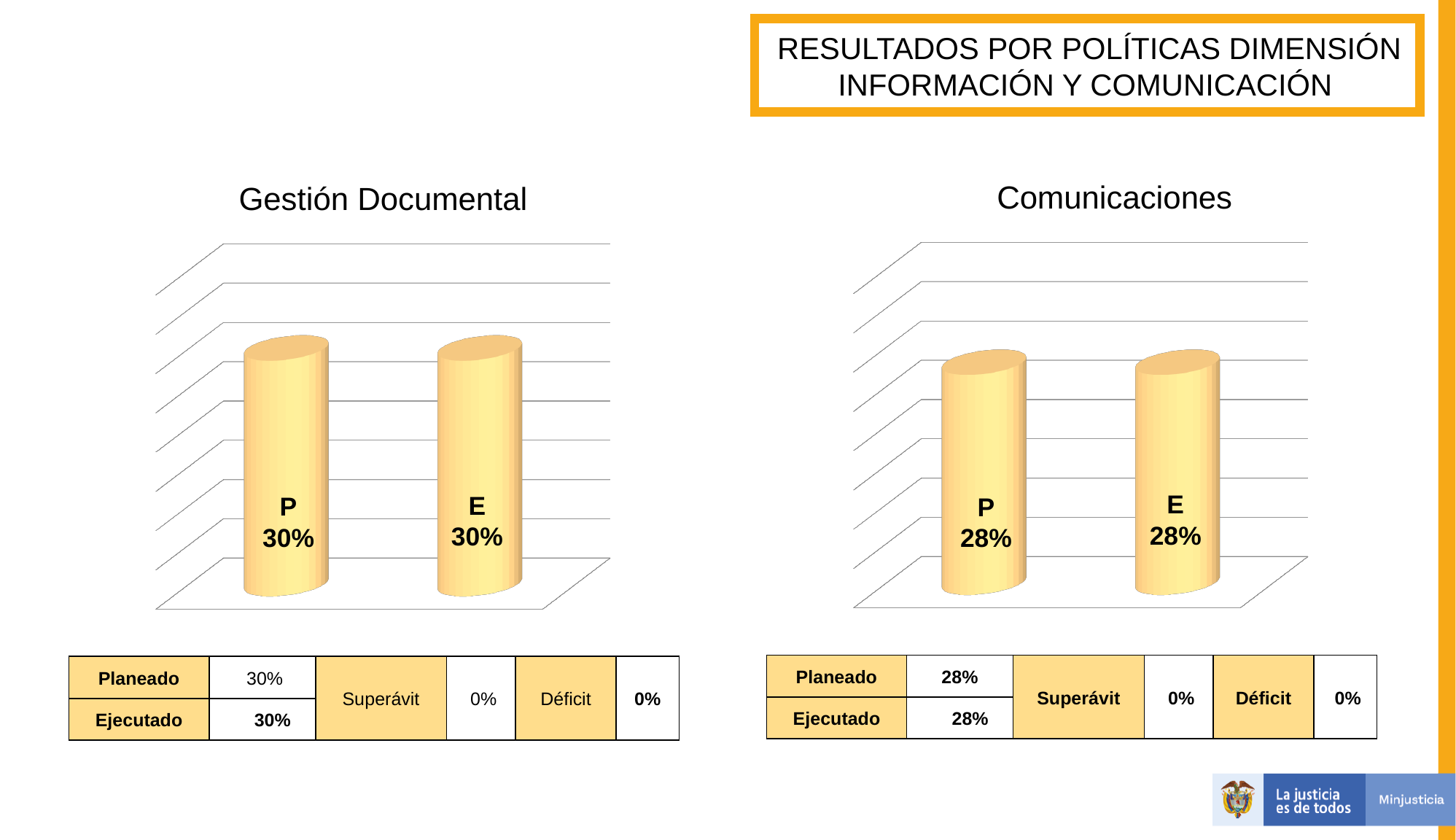
How many bars does the Comunicaciones chart show? 2 In the Gestión Documental chart, what is the difference between the P and E values? 0% In the Gestión Documental chart, what is the value for E? 30% In the Comunicaciones chart, what is the value for E? 28% What kind of chart is the Comunicaciones chart? Bar chart What kind of chart is the Gestión Documental chart? Bar chart What is the title of the chart on the left side of the slide? Gestión Documental In the Gestión Documental chart, what is the value for P? 30% What is the title of the chart on the right side of the slide? Comunicaciones In the Comunicaciones chart, what is the value for P? 28% How many bars does the Gestión Documental chart show? 2 In the Comunicaciones chart, what is the difference between the P and E values? 0%